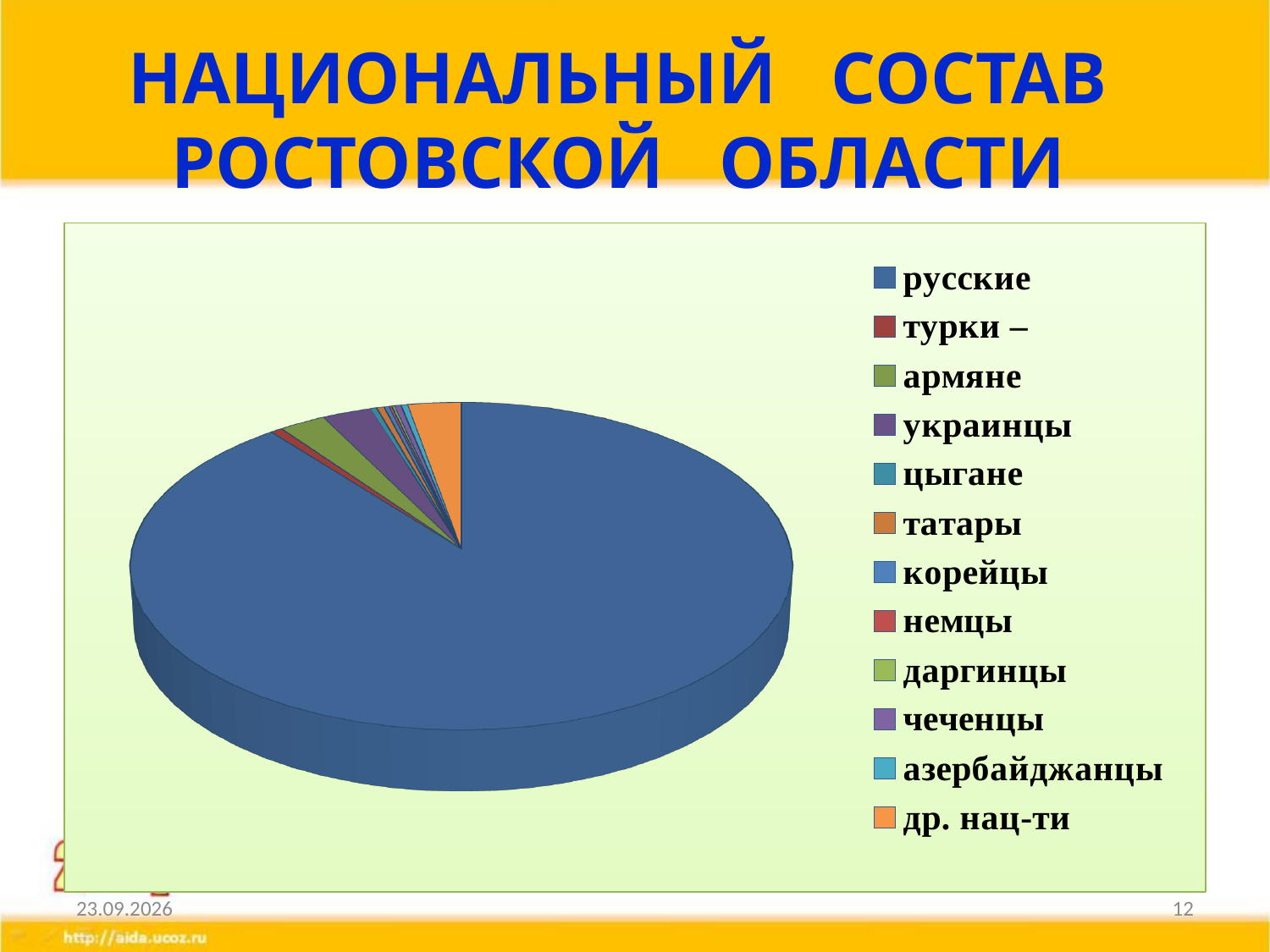
Which slice is larger, русские or армяне? русские Which category has the largest slice of the pie chart? русские How many categories does the legend of the pie chart list? 12 What is the first category listed in the legend of the pie chart? русские What is the title of the slide containing the pie chart? НАЦИОНАЛЬНЫЙ СОСТАВ РОСТОВСКОЙ ОБЛАСТИ Which slice is larger, украинцы or турки? украинцы Which slice is larger, армяне or турки? армяне What kind of chart is shown on the slide? pie chart